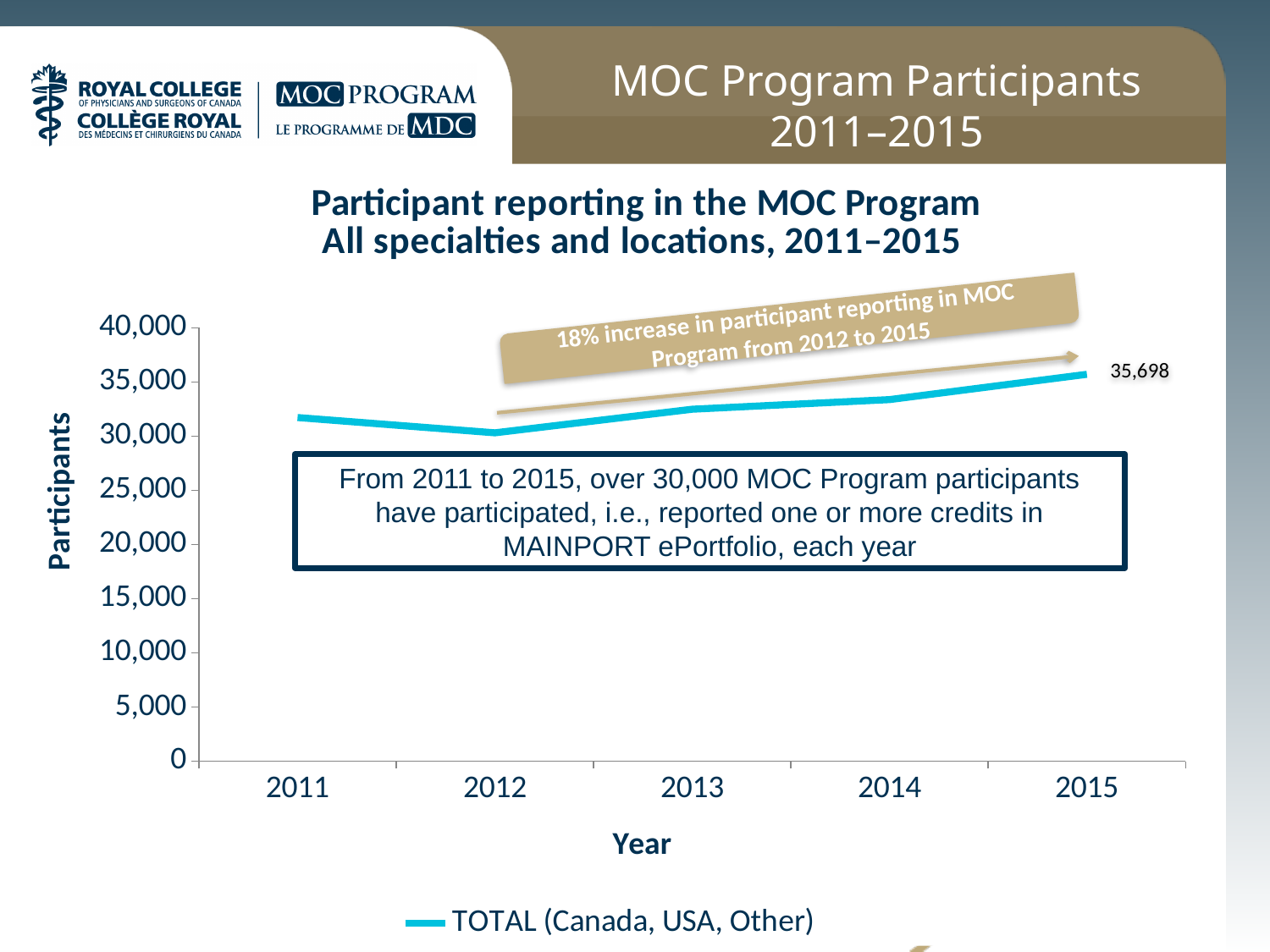
What kind of chart is shown? line chart Which year has more participants, 2011 or 2015? 2015 What is the value for 2015? 35,698 Do the values rise or fall from 2012 to 2015? rise Is the value for 2015 greater or less than 35,000? greater Which year has the lowest number of participants? 2012 Is the value for 2011 greater or less than 30,000? greater Which year has the highest number of participants? 2015 Is the value for 2012 greater or less than 35,000? less How many series does the legend list? 1 What is the legend entry for the plotted line? TOTAL (Canada, USA, Other) How many years are plotted on the x axis? 5